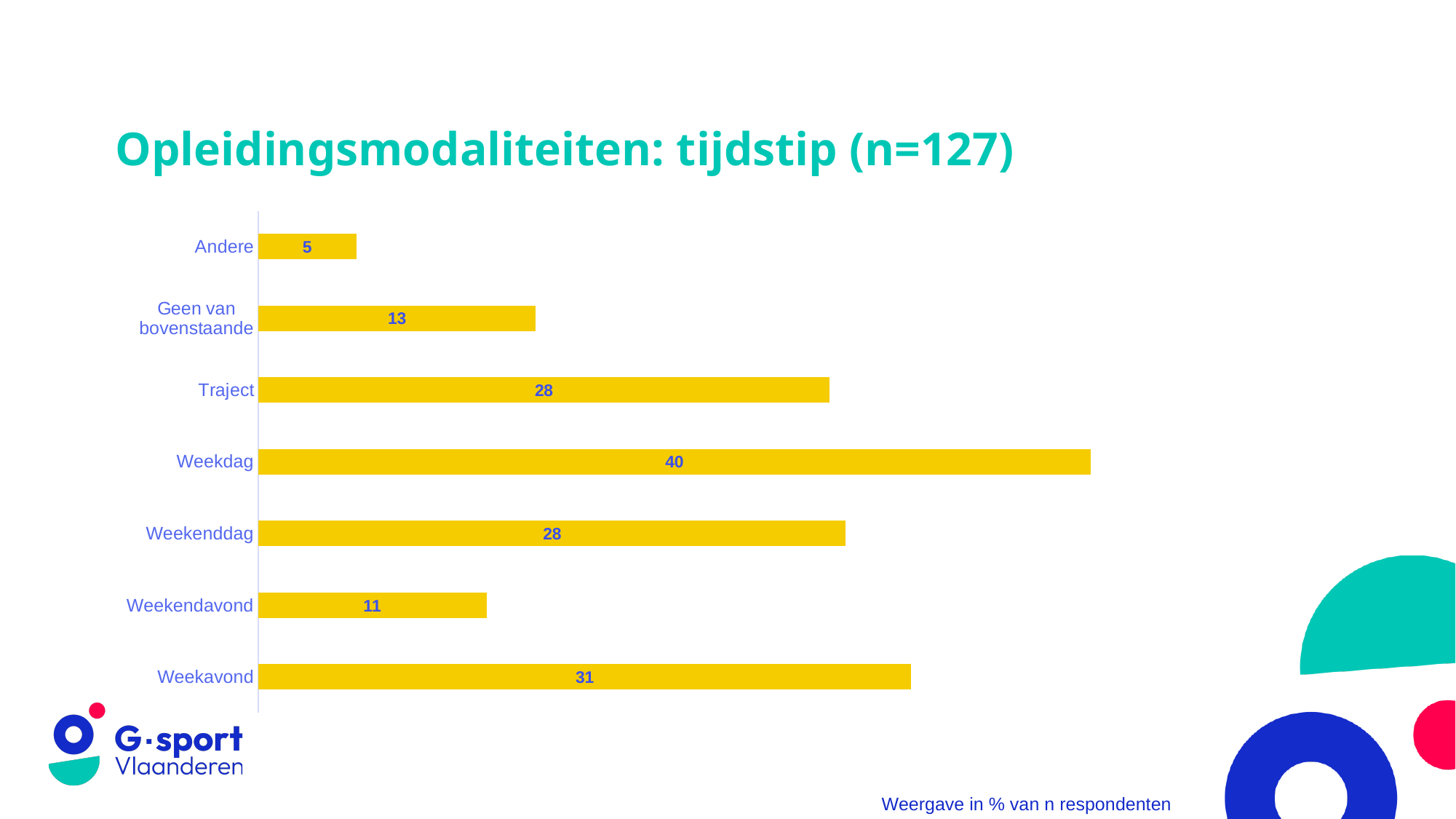
Which category has the lowest value? Andere What kind of chart is shown on the slide? Bar chart How many categories are shown in the chart? 7 What is the title of the chart? Opleidingsmodaliteiten: tijdstip (n=127) What is the difference between the values for Geen van bovenstaande and Andere? 8 What is the value for Weekavond? 31 What is the value for Weekdag? 40 What is the value for Geen van bovenstaande? 13 What is the value for Weekendavond? 11 What is the difference between the values for Weekdag and Weekavond? 9 Which category has the highest value? Weekdag Which is larger, the value for Weekavond or the value for Weekenddag? Weekavond